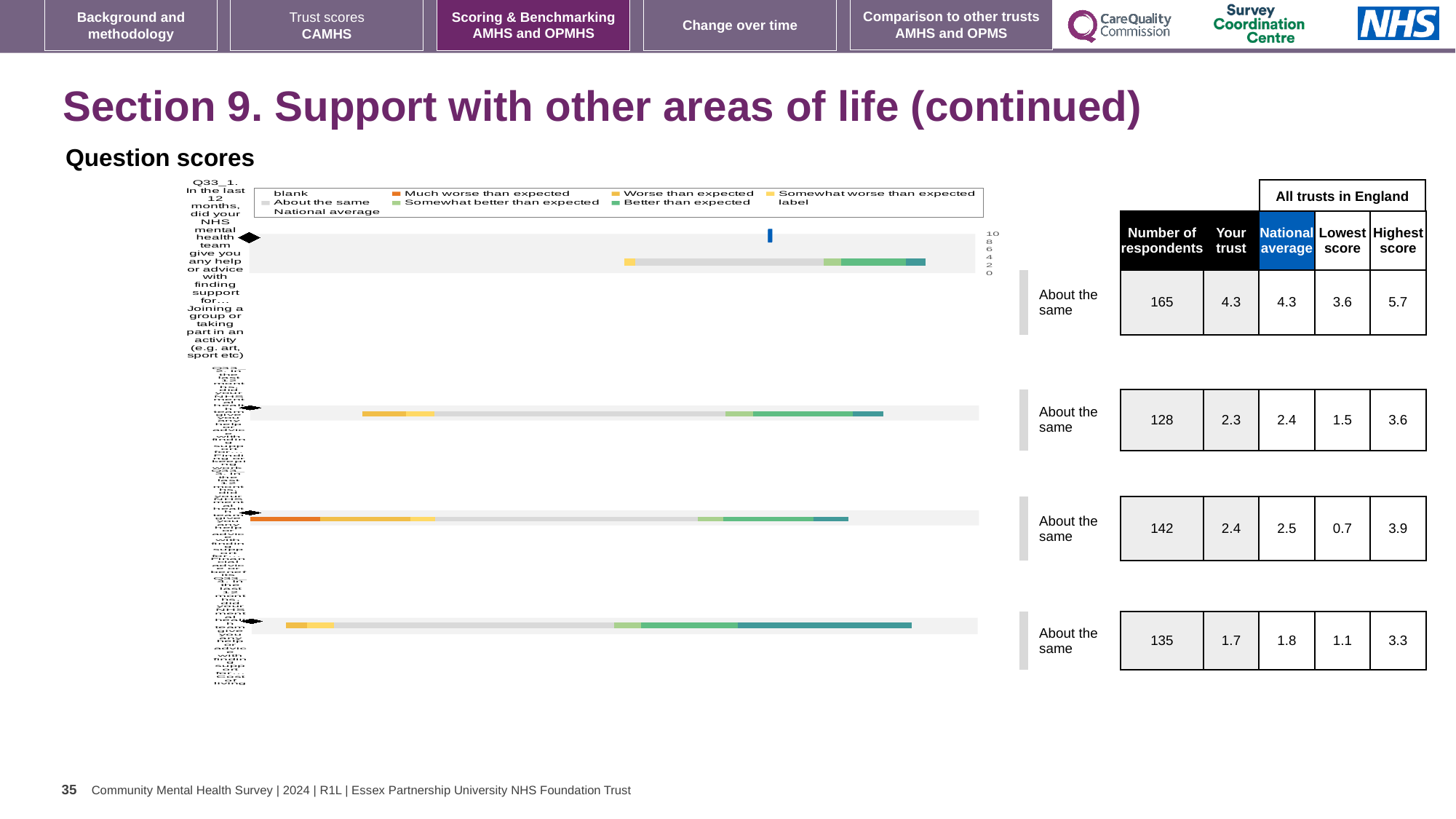
Which bar has the highest 'Your trust' score: the top bar or the bottom bar? the top bar What is the national average for the bottom bar? 1.8 Which legend entry is shown in orange in the chart's legend? Much worse than expected What is the lowest score across all trusts in England for the third bar from the top? 0.7 What is the 'Your trust' score for the top bar (Q33_1, joining a group or taking part in an activity)? 4.3 How many entries does the chart's legend list? 9 What is the highest score across all trusts in England for the top bar (Q33_1)? 5.7 How many horizontal bars (question rows) does the chart contain? 4 What kind of chart is shown under 'Question scores'? bar chart What is the number of respondents for the top bar (Q33_1, joining a group or taking part in an activity)? 165 What benchmark label is shown beside every bar in the chart? About the same What is the difference between the highest score (5.7) and the lowest score (3.6) for the top bar (Q33_1)? 2.1